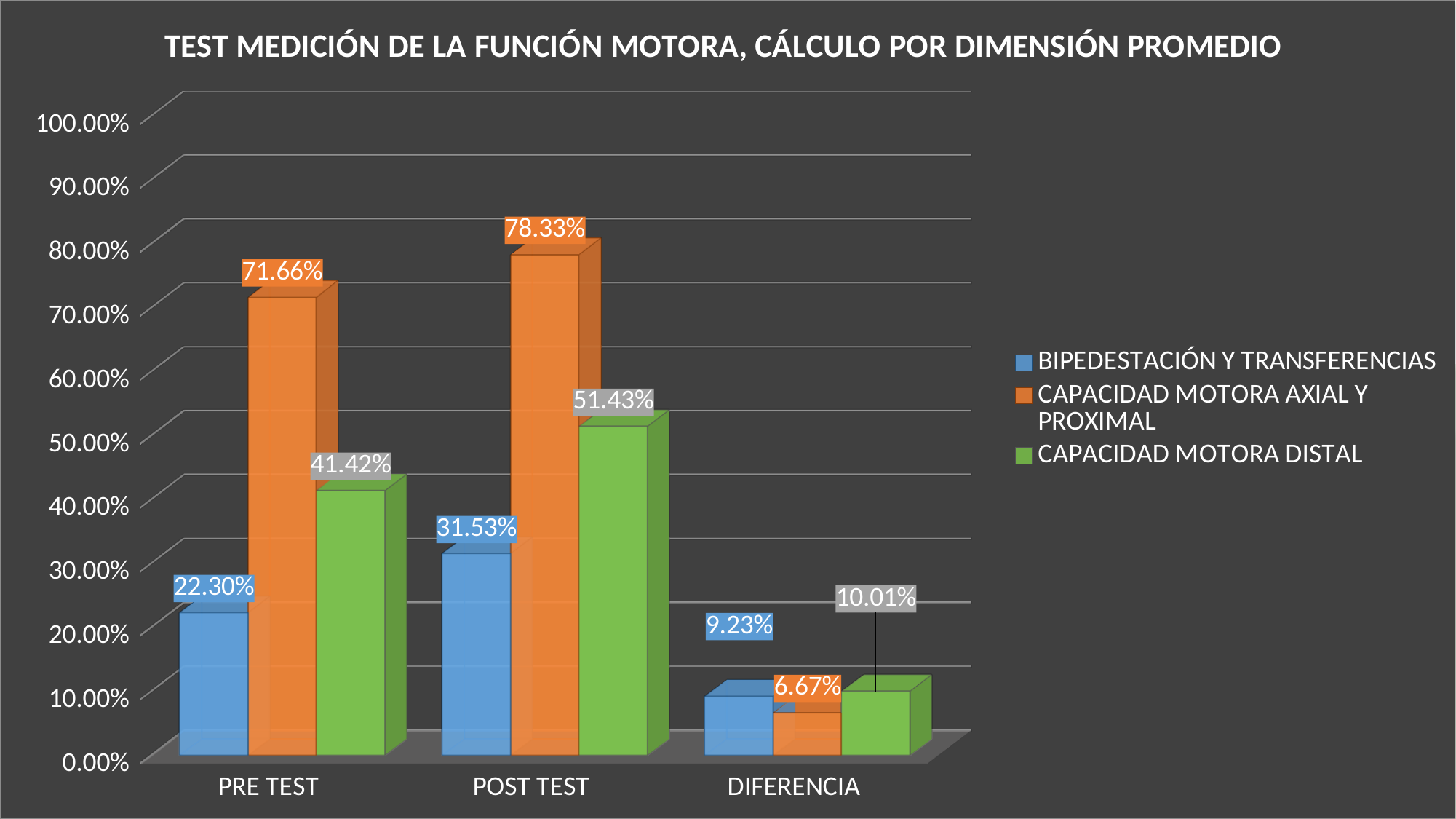
What is the difference between the POST TEST and PRE TEST values for CAPACIDAD MOTORA DISTAL? 10.01% What kind of chart is shown on the slide? Bar chart How many series does the legend list? 3 How many categories are shown on the x axis? 3 Is the PRE TEST value for CAPACIDAD MOTORA AXIAL Y PROXIMAL greater or less than 70.00%? greater What is the value for CAPACIDAD MOTORA AXIAL Y PROXIMAL in the POST TEST category? 78.33% What is the value for BIPEDESTACIÓN Y TRANSFERENCIAS in the PRE TEST category? 22.30% What is the title of the chart? TEST MEDICIÓN DE LA FUNCIÓN MOTORA, CÁLCULO POR DIMENSIÓN PROMEDIO Which series has the highest value in the PRE TEST category? CAPACIDAD MOTORA AXIAL Y PROXIMAL What is the value for CAPACIDAD MOTORA DISTAL in the DIFERENCIA category? 10.01% Which series has the lowest value in the DIFERENCIA category? CAPACIDAD MOTORA AXIAL Y PROXIMAL Which is larger: the POST TEST value for BIPEDESTACIÓN Y TRANSFERENCIAS or the PRE TEST value for CAPACIDAD MOTORA DISTAL? PRE TEST value for CAPACIDAD MOTORA DISTAL